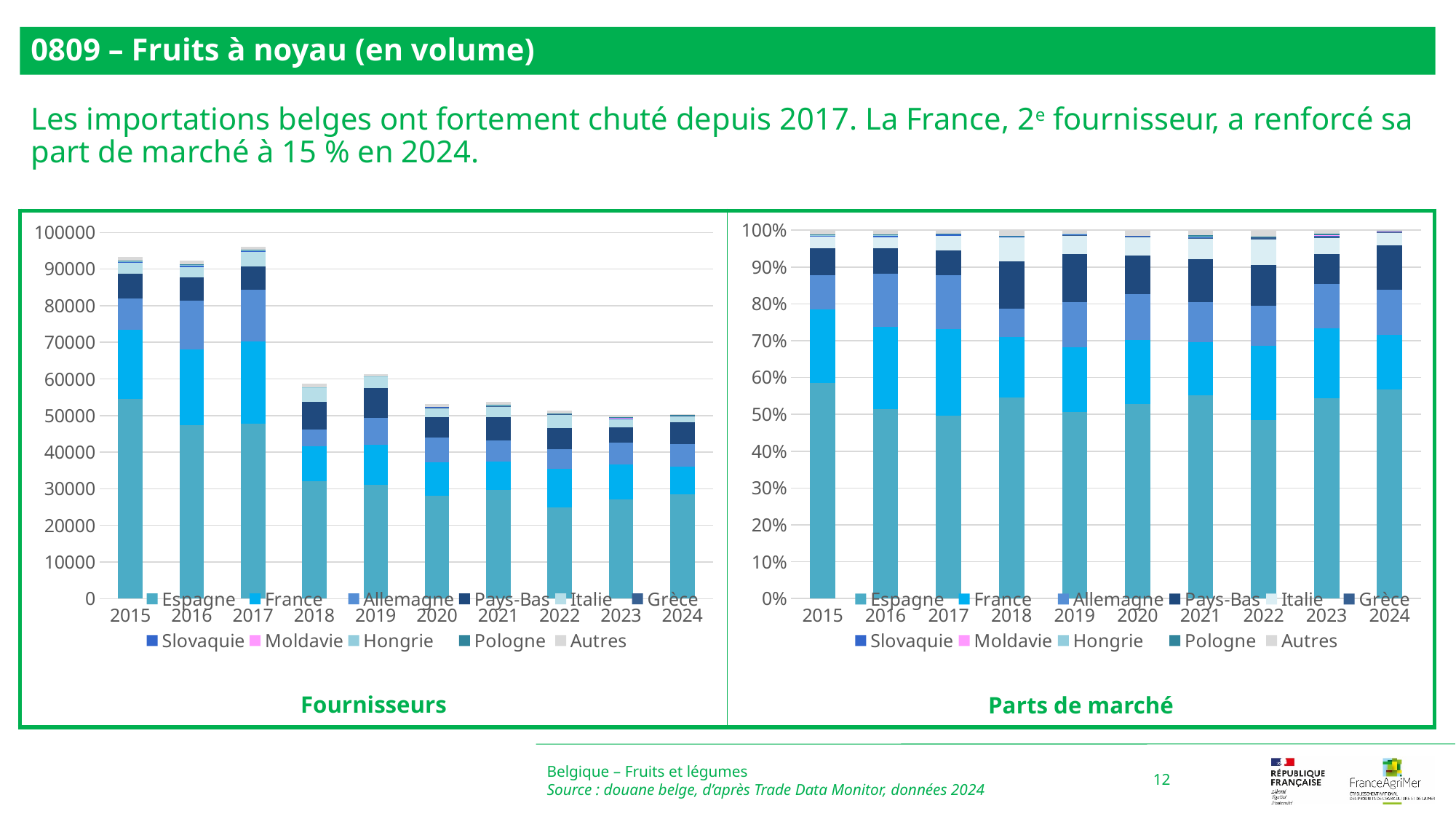
How many years are shown on the x axis of the 'Fournisseurs' chart? 10 How many series does the legend of the 'Parts de marché' chart list? 11 What is the title of the chart on the right of the slide? Parts de marché In the 'Fournisseurs' chart, which year has the highest total stacked bar? 2017 In the 'Parts de marché' chart, is the share of Espagne in 2022 greater or less than 50%? less In the 'Fournisseurs' chart, is the total for 2015 greater or less than 90000? greater In the 'Fournisseurs' chart, which year has the larger total, 2015 or 2018? 2015 In the 'Fournisseurs' chart, is the total for 2018 greater or less than 60000? less In the 'Fournisseurs' chart, do the total bars rise or fall from 2017 to 2024? fall What kind of chart is the 'Fournisseurs' chart on the left? stacked bar chart Which series is listed first in the legend of the 'Fournisseurs' chart? Espagne